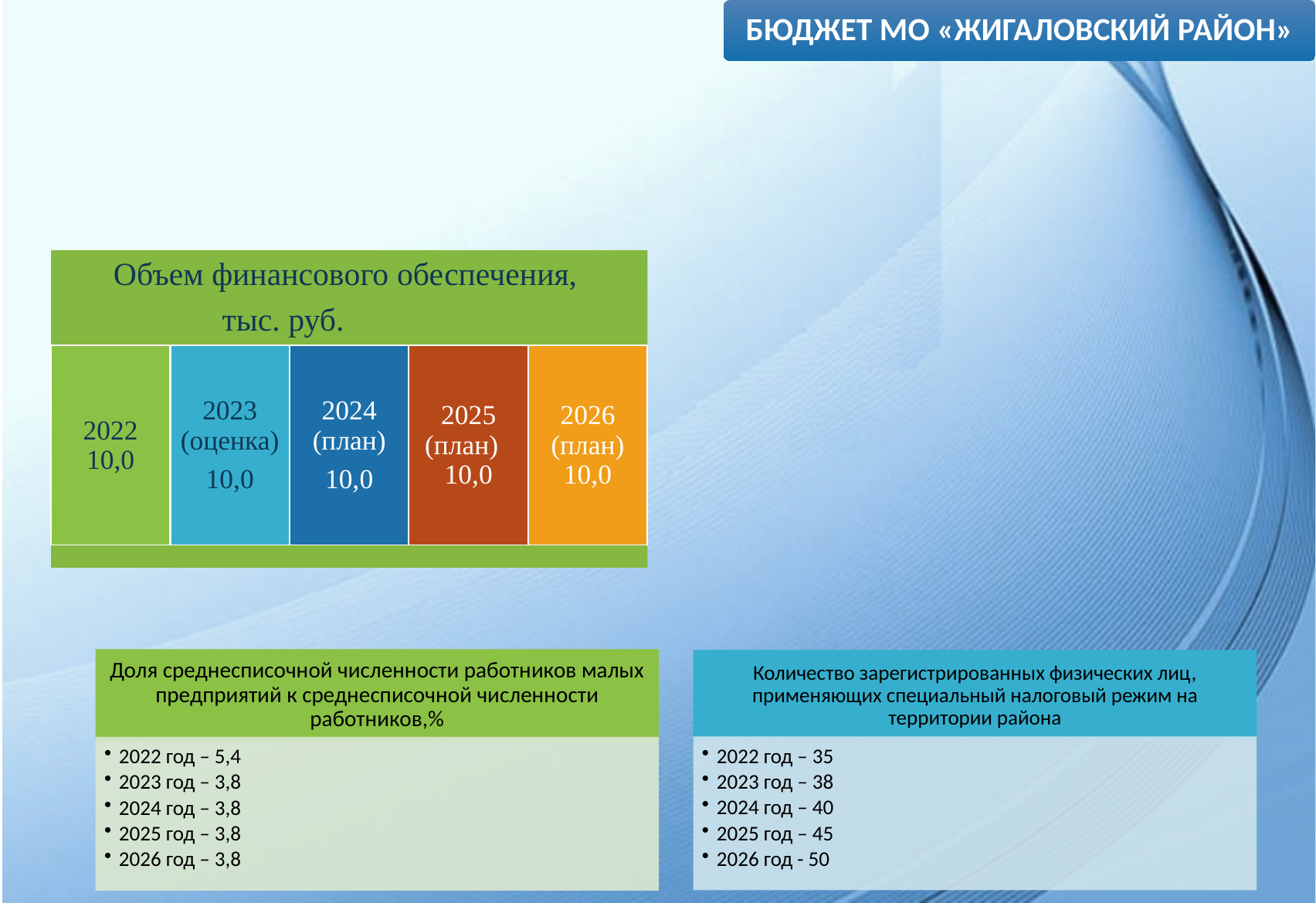
In the chart 'Объем финансового обеспечения, тыс. руб.', what is the value for 2023 (оценка)? 10,0 In the chart 'Объем финансового обеспечения, тыс. руб.', what is the value for 2026 (план)? 10,0 In the chart 'Объем финансового обеспечения, тыс. руб.', what is the value for 2024 (план)? 10,0 In the chart 'Объем финансового обеспечения, тыс. руб.', what is the value for 2022? 10,0 In the chart 'Объем финансового обеспечения, тыс. руб.', do the values rise, fall, or stay the same from 2022 to 2026? stay the same In the chart 'Объем финансового обеспечения, тыс. руб.', is the value for 2023 (оценка) larger than, smaller than, or equal to the value for 2024 (план)? equal How many years (categories) are shown in the chart 'Объем финансового обеспечения, тыс. руб.'? 5 In the chart 'Объем финансового обеспечения, тыс. руб.', what is the difference between the values for 2022 and 2025 (план)? 0,0 In what units are the values in the chart 'Объем финансового обеспечения' given? тыс. руб. In the chart 'Объем финансового обеспечения, тыс. руб.', what is the sum of the values for all five years? 50,0 In the chart 'Объем финансового обеспечения, тыс. руб.', which year is labelled 'оценка'? 2023